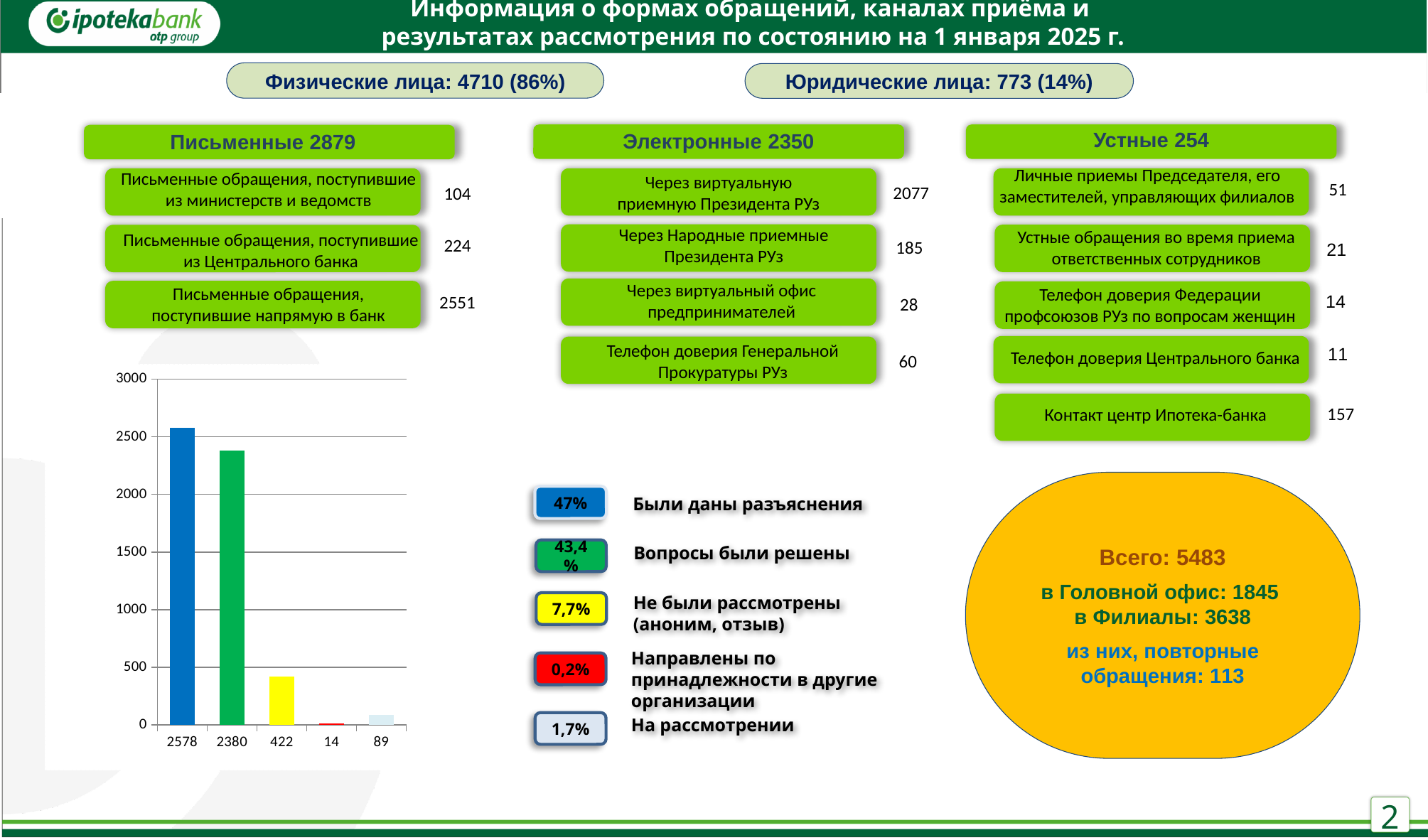
What is the highest tick value shown on the y axis of the bar chart? 3000 What kind of chart is shown on the left side of the slide? bar chart Is the value of the green bar in the bar chart greater or less than 2000? greater How many bars does the bar chart on the left contain? 5 Is the value of the yellow bar in the bar chart greater or less than 500? less What is the value of the yellow bar in the bar chart? 422 What is the value of the light blue (last) bar in the bar chart? 89 What is the value of the green bar in the bar chart? 2380 What is the value of the tallest bar in the bar chart? 2578 What is the difference between the blue bar (2578) and the green bar (2380) in the bar chart? 198 What is the value of the shortest bar in the bar chart? 14 Which bar is taller in the bar chart: the yellow bar or the light blue bar? the yellow bar